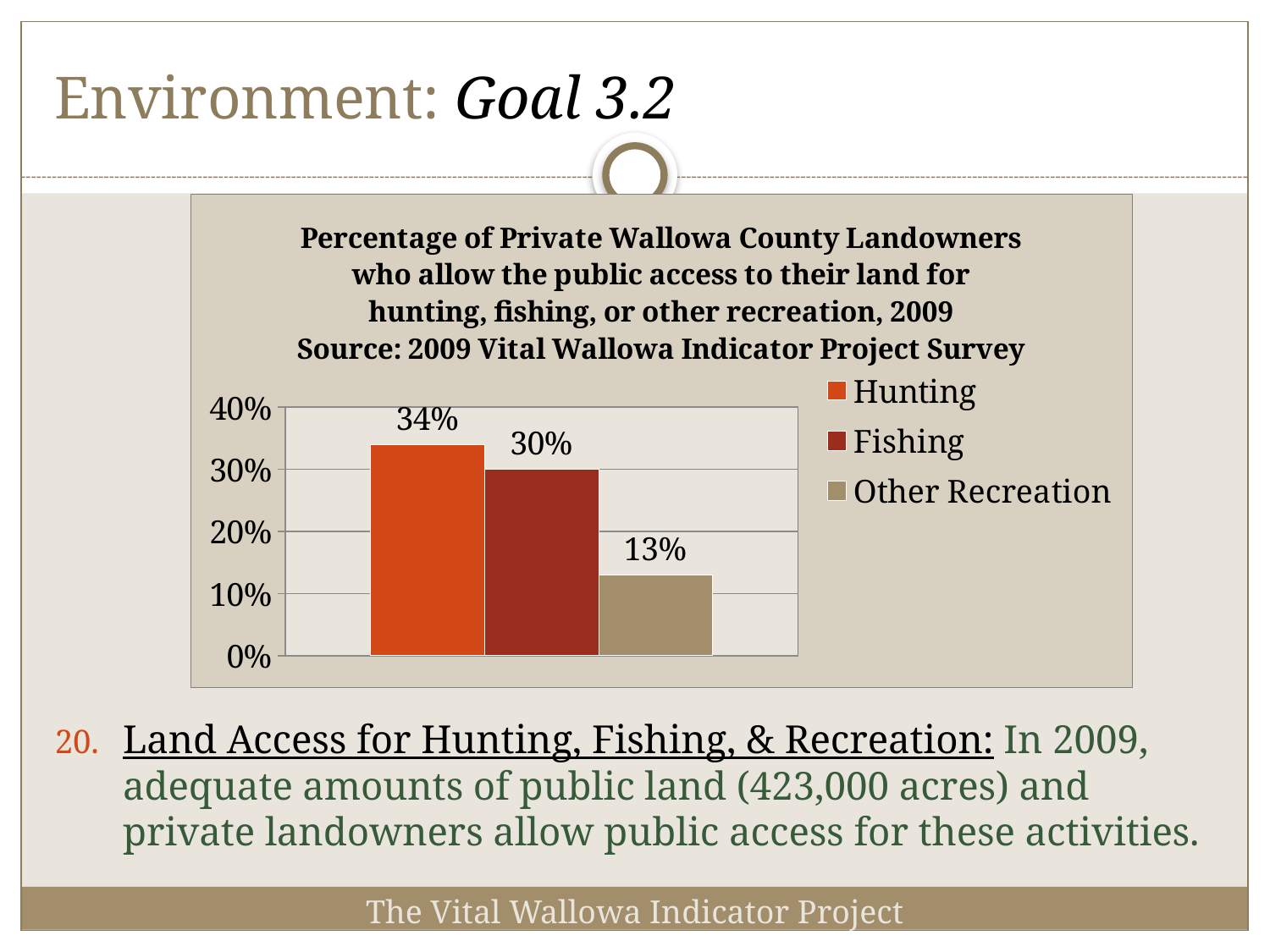
What kind of chart is shown on the slide? Bar chart Which activity has the highest percentage of landowners allowing public access? Hunting What percentage of private Wallowa County landowners allow public access for other recreation? 13% What percentage of private Wallowa County landowners allow public access for fishing? 30% What is the difference in percentage points between Hunting and Other Recreation? 21 What is the source cited in the chart title? 2009 Vital Wallowa Indicator Project Survey Which activity has the lowest percentage of landowners allowing public access? Other Recreation What percentage of private Wallowa County landowners allow public access for hunting? 34% Is the value for Fishing greater or less than 20%? greater How many series does the legend list? 3 What is the difference in percentage points between Hunting and Fishing? 4 Which is larger, the value for Fishing or the value for Other Recreation? Fishing